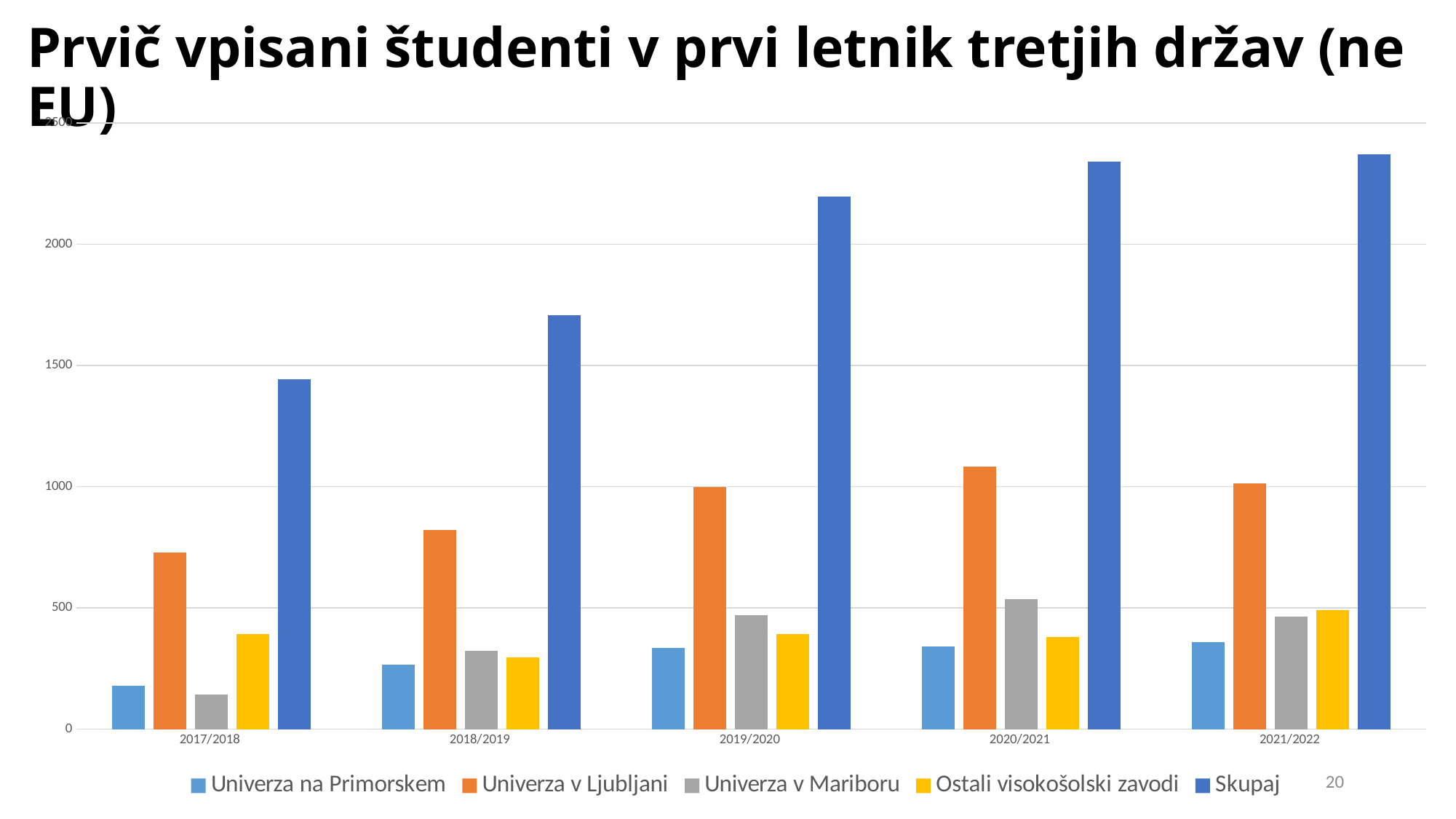
Is the Univerza v Ljubljani value for 2018/2019 greater or less than 1000? less Does the Skupaj series rise or fall from 2017/2018 to 2021/2022? rises Is the Skupaj value for 2017/2018 greater or less than 1500? less Is the Univerza v Ljubljani value for 2020/2021 greater or less than 1000? greater How many academic years are shown on the x axis? 5 In which academic year is the Skupaj value lowest? 2017/2018 In 2020/2021, which is larger: Univerza v Mariboru or Ostali visokošolski zavodi? Univerza v Mariboru What kind of chart is shown on the slide? bar chart In 2017/2018, which is larger: Univerza v Mariboru or Ostali visokošolski zavodi? Ostali visokošolski zavodi How many series does the legend list? 5 Which series is represented by the orange bars in the legend? Univerza v Ljubljani